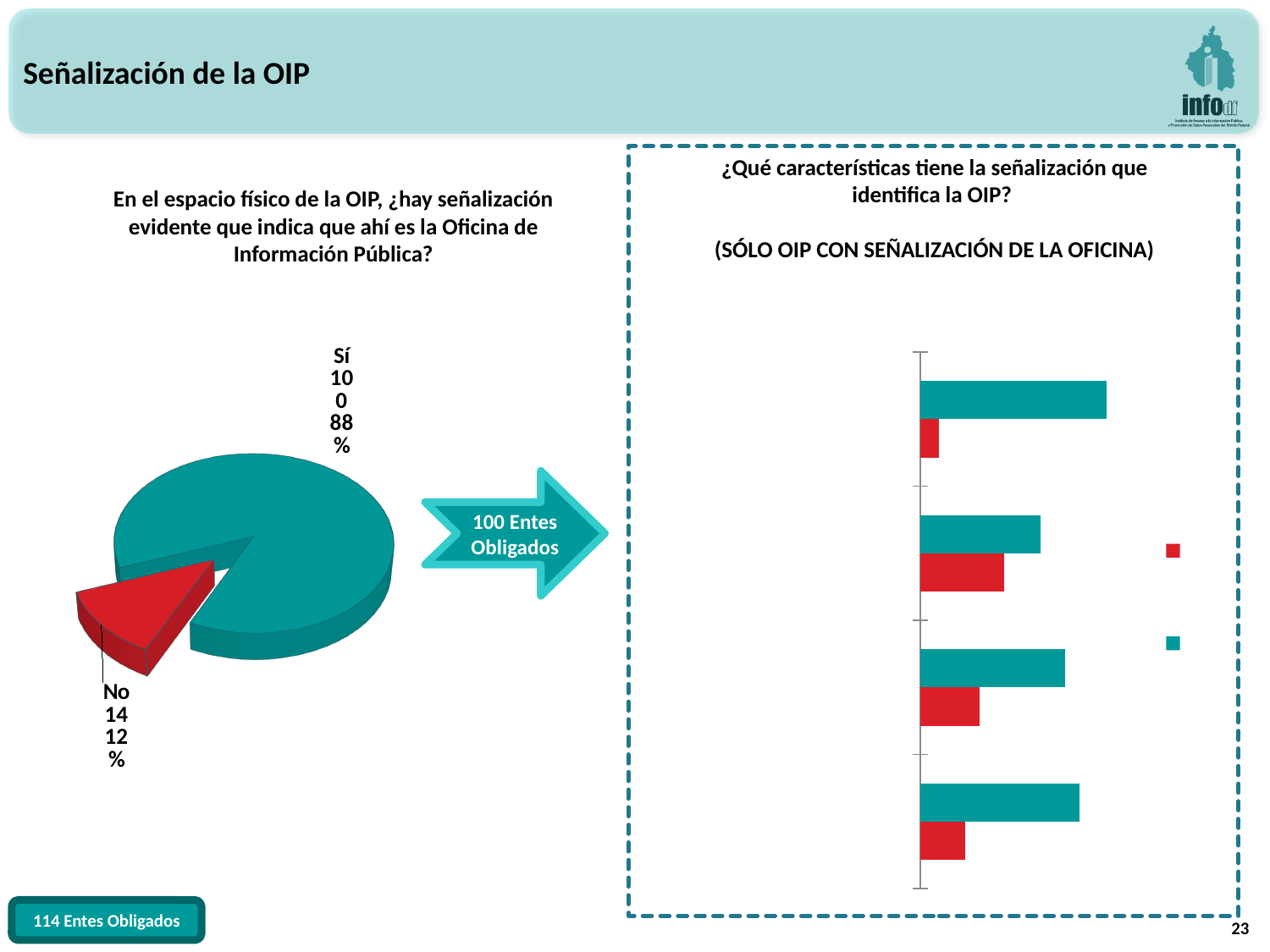
In the pie chart on the left, how many more entes obligados answered "Sí" than "No"? 86 In the bar chart on the right, how many colours of bars does the legend show? 2 In the pie chart on the left, how many entes obligados answered "Sí"? 100 In the pie chart on the left, what percentage is shown for "No"? 12% What kind of chart is shown inside the dashed box on the right side of the slide? Bar chart In the pie chart on the left, what percentage is shown for "Sí"? 88% What kind of chart is shown on the left side of the slide? Pie chart In the pie chart on the left, how many entes obligados answered "No"? 14 In the pie chart on the left, which category has the smallest slice? No In the pie chart on the left, how many slices does the pie have? 2 In the pie chart on the left, which category has the largest slice? Sí In the pie chart on the left, what is the difference in percentage points between "Sí" and "No"? 76